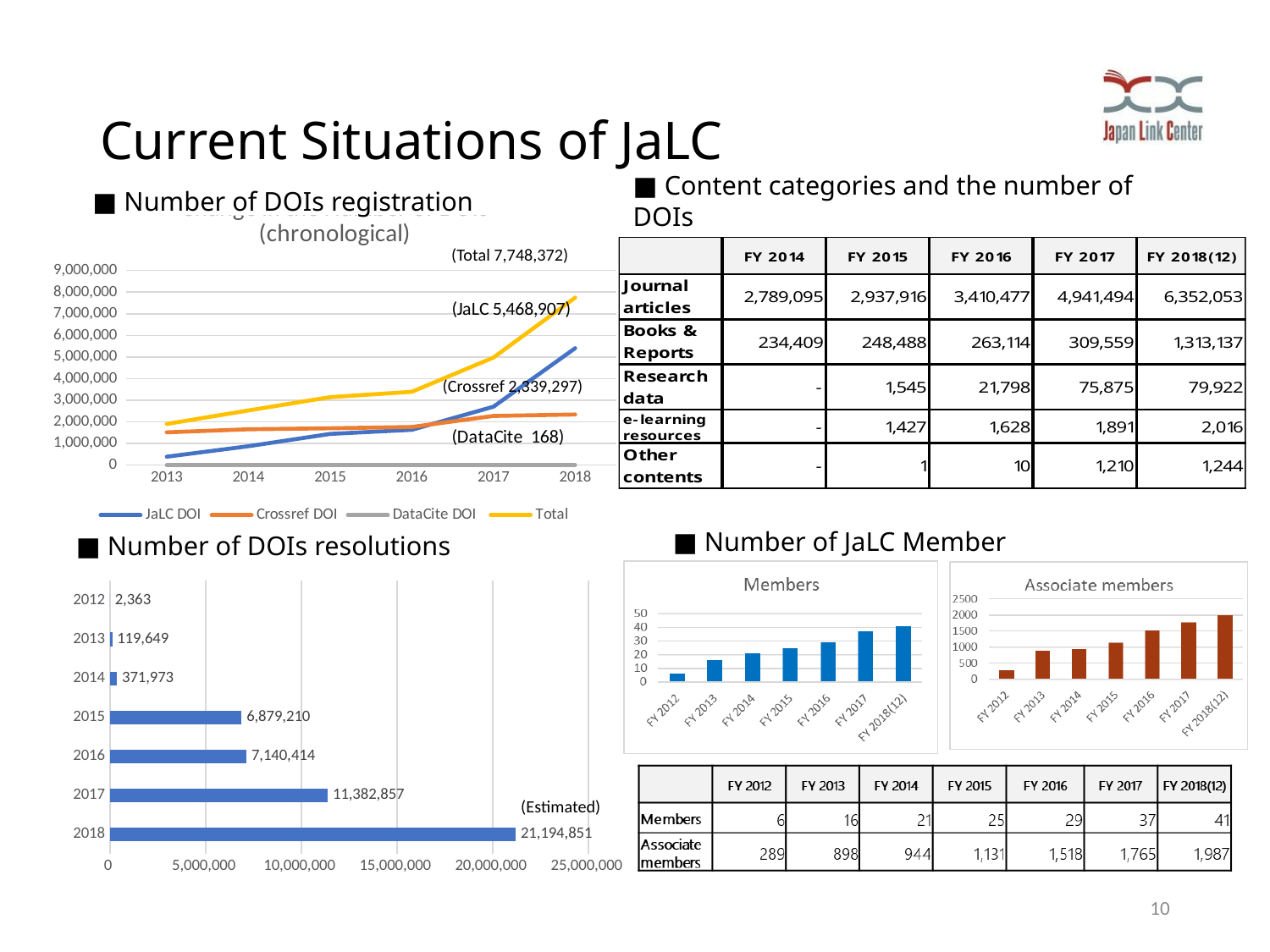
In the 'Number of DOIs resolutions' chart, what is the value for 2015? 6,879,210 In the 'Number of DOIs resolutions' chart, how many years are shown? 7 In the 'Number of DOIs registration (chronological)' line chart, how many series does the legend list? 4 In the 'Number of DOIs resolutions' chart, what is the difference between the values for 2016 and 2015? 261,204 In the 'Number of DOIs resolutions' chart, what is the value for 2017? 11,382,857 In the 'Number of DOIs registration (chronological)' line chart, what is the labelled value for JaLC in 2018? 5,468,907 In the 'Number of DOIs resolutions' chart, which year has the lowest value? 2012 In the 'Number of DOIs registration (chronological)' line chart, does the Total series rise or fall from 2013 to 2018? Rise In the 'Number of DOIs resolutions' chart, which year has the highest value? 2018 In the 'Number of DOIs registration (chronological)' line chart, is the Crossref DOI value for 2018 greater or less than 3,000,000? less What kind of chart is the 'Number of DOIs resolutions' chart? Bar chart In the 'Members' bar chart, is the value for FY 2018(12) greater or less than 30? greater